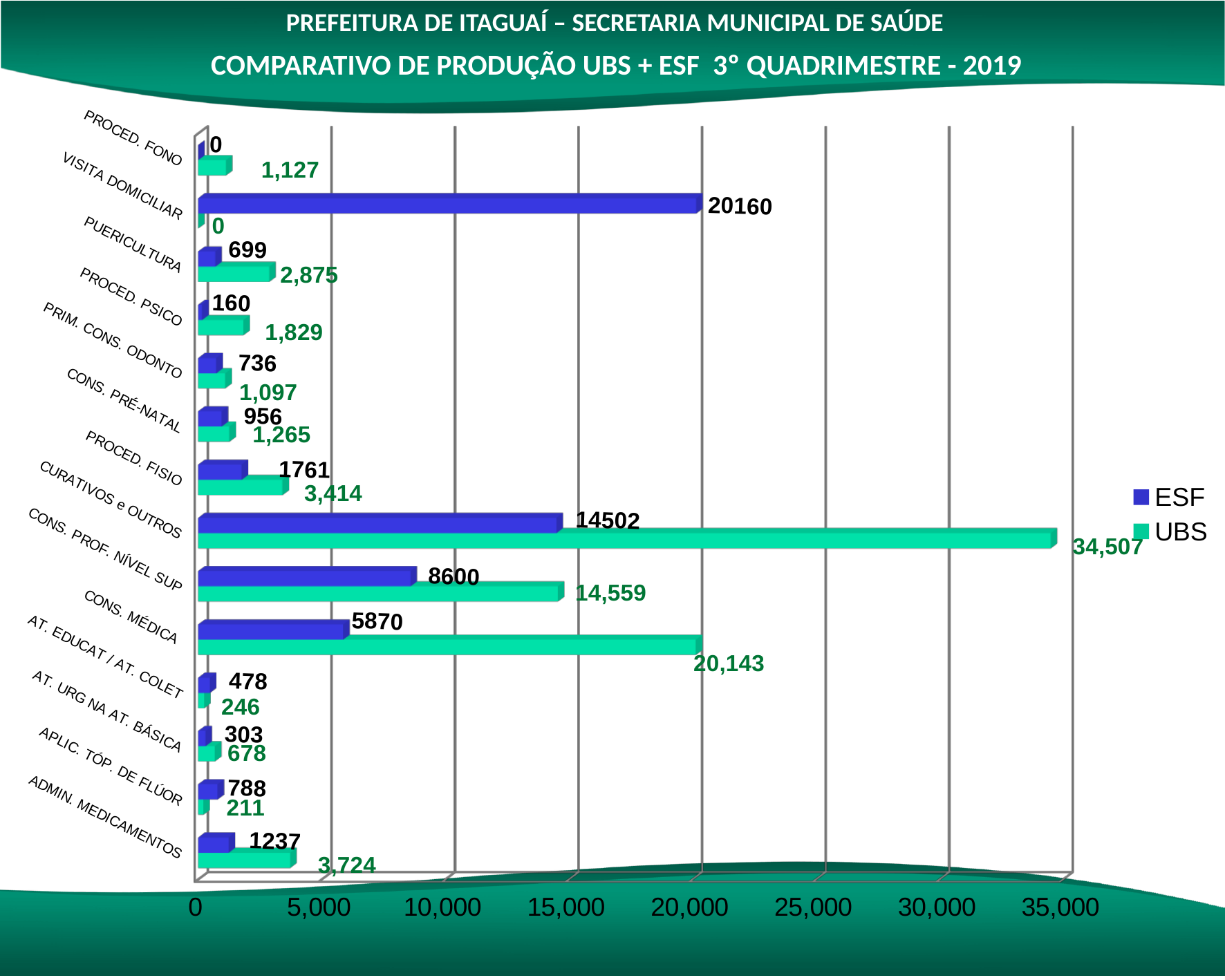
Which category has the lowest ESF value? PROCED. FONO What is the difference between the UBS and ESF values for CONS. PROF. NÍVEL SUP? 5,959 What is the UBS value for CURATIVOS e OUTROS? 34,507 For AT. EDUCAT / AT. COLET, which series has the larger value, ESF or UBS? ESF What is the UBS value for CONS. MÉDICA? 20,143 What kind of chart is shown on the slide? Bar chart What is the ESF value for ADMIN. MEDICAMENTOS? 1237 Which category has the highest UBS value? CURATIVOS e OUTROS How many categories are shown on the chart? 14 What is the ESF value for VISITA DOMICILIAR? 20160 How many series does the legend list? 2 Which category has the highest ESF value? VISITA DOMICILIAR